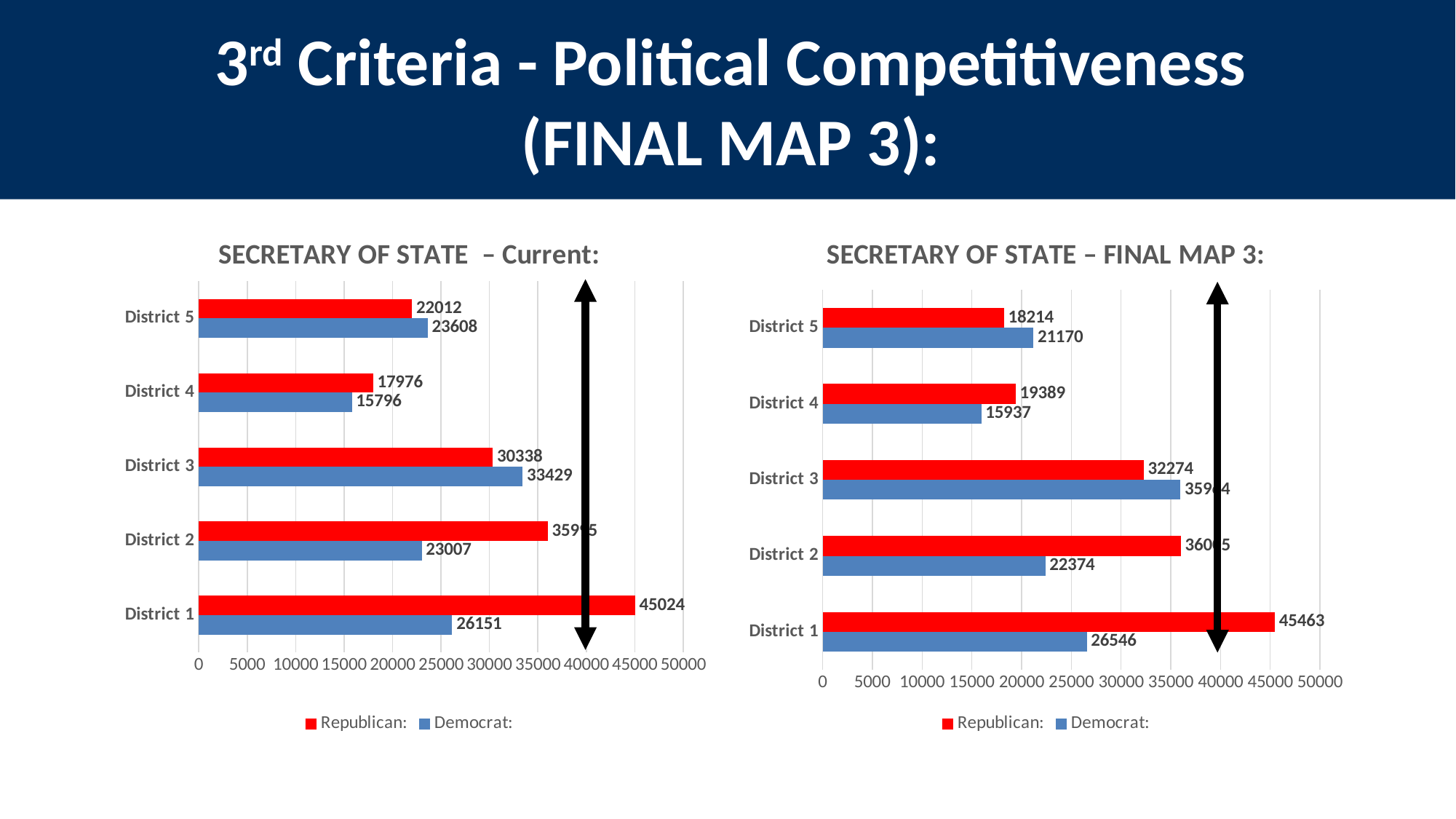
In the SECRETARY OF STATE – FINAL MAP 3 chart, is the Republican value for District 2 greater or less than 30000? greater How many series does the legend of the SECRETARY OF STATE – Current chart list? 2 In the SECRETARY OF STATE – FINAL MAP 3 chart, what is the Democrat value for District 5? 21170 In the SECRETARY OF STATE – Current chart, what is the difference between the Republican and Democrat values for District 1? 18873 In the SECRETARY OF STATE – Current chart, what is the Republican value for District 1? 45024 In the SECRETARY OF STATE – FINAL MAP 3 chart, which district has the lowest Democrat value? District 4 In the SECRETARY OF STATE – Current chart, is the Republican or Democrat value larger for District 4? Republican How many districts are shown in the SECRETARY OF STATE – FINAL MAP 3 chart? 5 In the SECRETARY OF STATE – Current chart, what is the Democrat value for District 3? 33429 In the SECRETARY OF STATE – Current chart, which district has the highest Republican value? District 1 In the SECRETARY OF STATE – FINAL MAP 3 chart, what is the Republican value for District 4? 19389 In the SECRETARY OF STATE – FINAL MAP 3 chart, what is the difference between the Democrat and Republican values for District 5? 2956